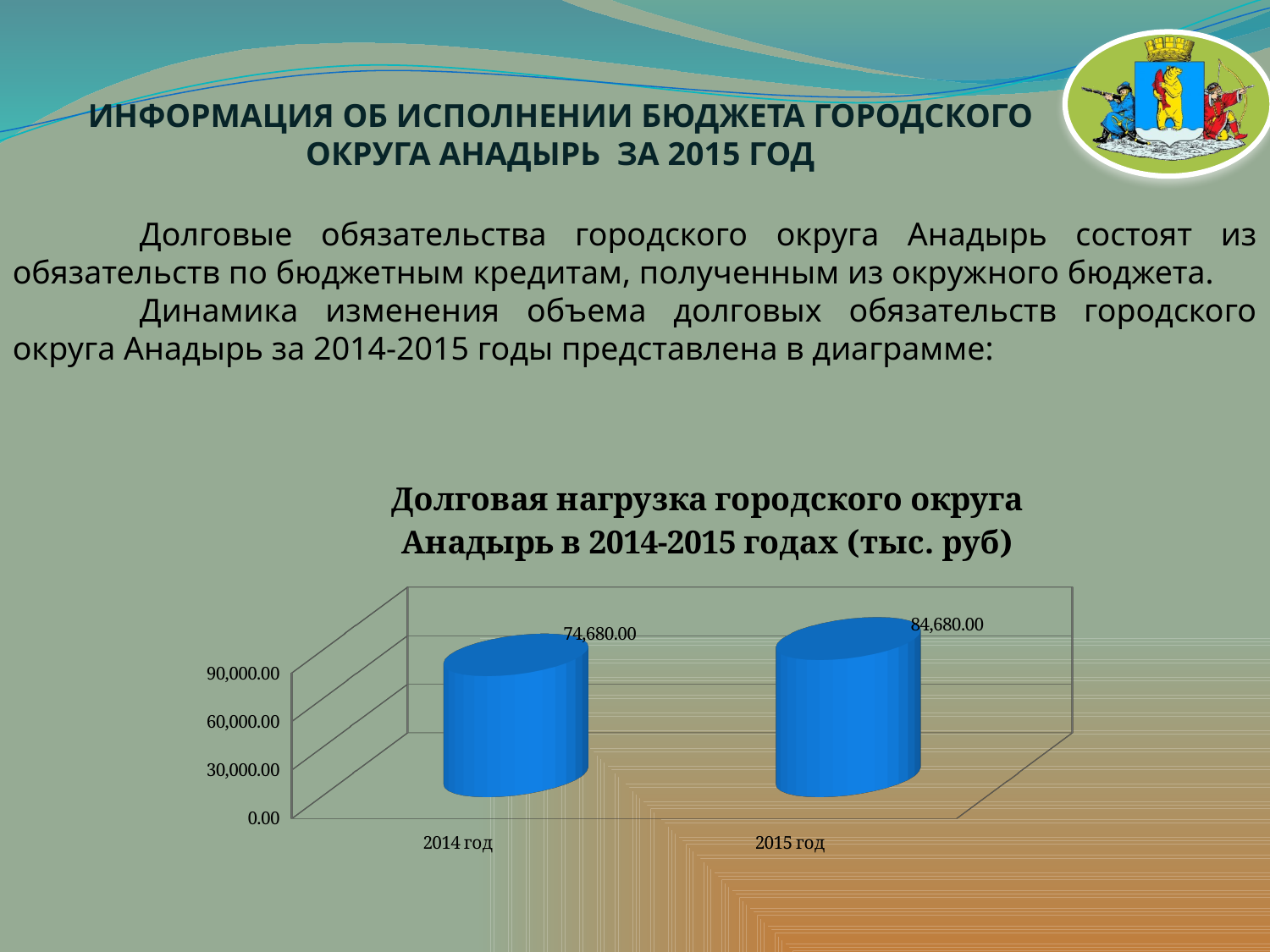
Is the value for 2014 год larger or smaller than the value for 2015 год? smaller How many categories are shown on the x axis? 2 What is the difference between the values for 2015 год and 2014 год? 10,000.00 What is the value for 2015 год? 84,680.00 What is the value for 2014 год? 74,680.00 Is the value for 2014 год greater or less than 60,000.00? greater Do the values rise or fall from 2014 год to 2015 год? rise Is the value for 2015 год greater or less than 90,000.00? less What kind of chart is shown on the slide? bar chart Which year has the higher debt load? 2015 год What is the title of the chart? Долговая нагрузка городского округа Анадырь в 2014-2015 годах (тыс. руб) Which year has the lower debt load? 2014 год